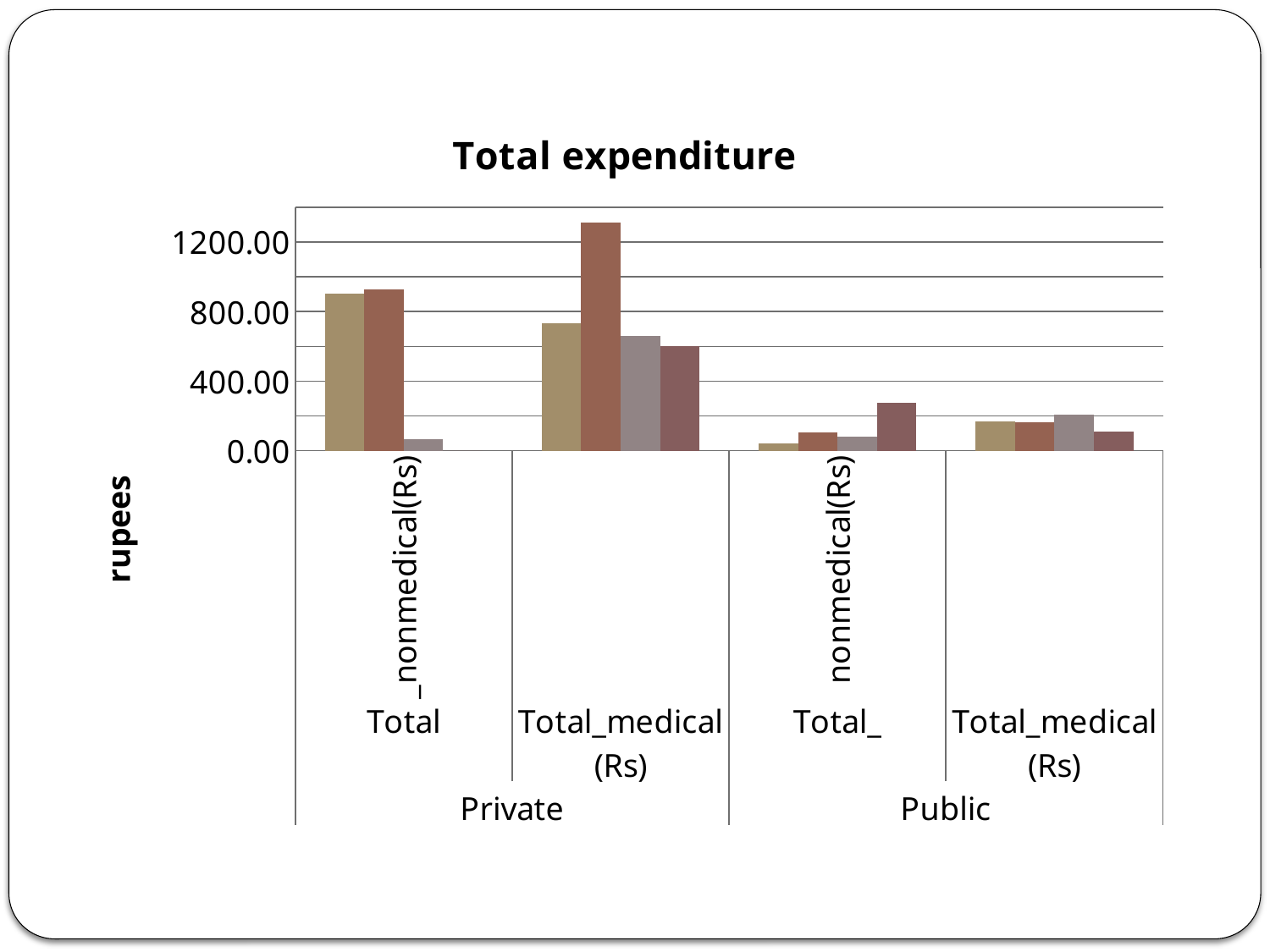
Which category group contains the tallest bar in the chart? Total_medical (Rs) under Private What is the label on the vertical axis of the chart? rupees How many bars are shown in the Private Total_nonmedical(Rs) group? 3 What is the title of the chart? Total expenditure Is the tallest bar in the Private Total_medical (Rs) group greater or less than 1200.00? greater Are all the bars in the Public Total_nonmedical(Rs) group greater or less than 400.00? less What kind of chart is shown on the slide? bar chart Are all the bars in the Public Total_medical (Rs) group greater or less than 400.00? less Which is larger: the tallest bar in the Private Total_medical (Rs) group or the tallest bar in the Private Total_nonmedical(Rs) group? Private Total_medical (Rs) Which sector, Private or Public, has the taller bars overall in the chart? Private How many category groups are shown along the x axis of the chart? 4